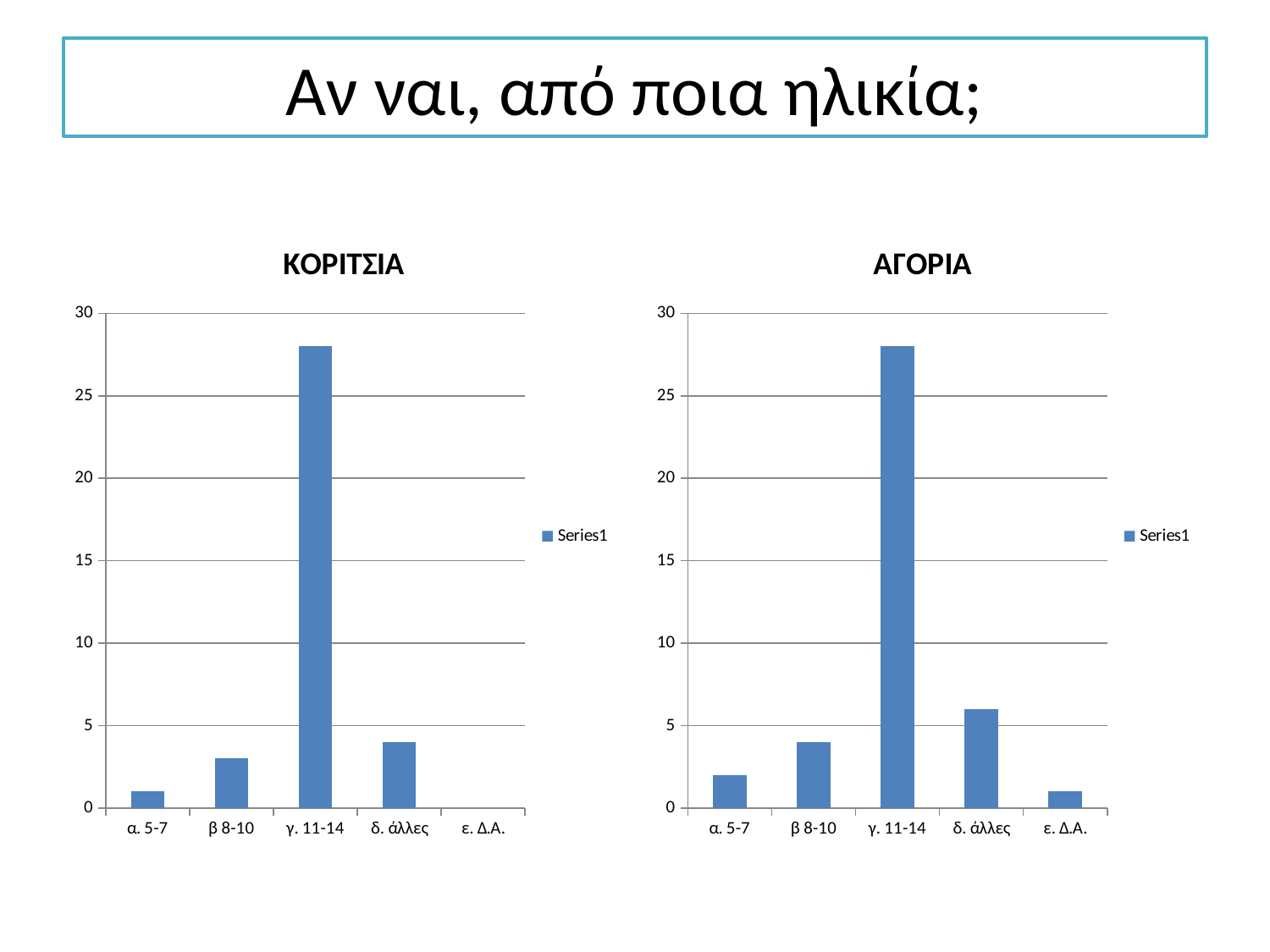
What kind of chart is the ΑΓΟΡΙΑ chart? bar chart How many series does the legend of the ΚΟΡΙΤΣΙΑ chart list? 1 In the ΑΓΟΡΙΑ chart, which category has the highest value? γ. 11-14 In the ΑΓΟΡΙΑ chart, which is larger, the value for δ. άλλες or the value for β 8-10? δ. άλλες In the ΚΟΡΙΤΣΙΑ chart, is the value for δ. άλλες greater or less than 5? less In the ΑΓΟΡΙΑ chart, is the value for δ. άλλες greater or less than 5? greater In the ΚΟΡΙΤΣΙΑ chart, which is larger, the value for γ. 11-14 or the value for δ. άλλες? γ. 11-14 In the ΑΓΟΡΙΑ chart, is the value for β 8-10 greater or less than 5? less In the ΚΟΡΙΤΣΙΑ chart, which category has the lowest value? ε. Δ.Α. In the ΚΟΡΙΤΣΙΑ chart, which category has the highest value? γ. 11-14 How many categories are shown on the x axis of the ΑΓΟΡΙΑ chart? 5